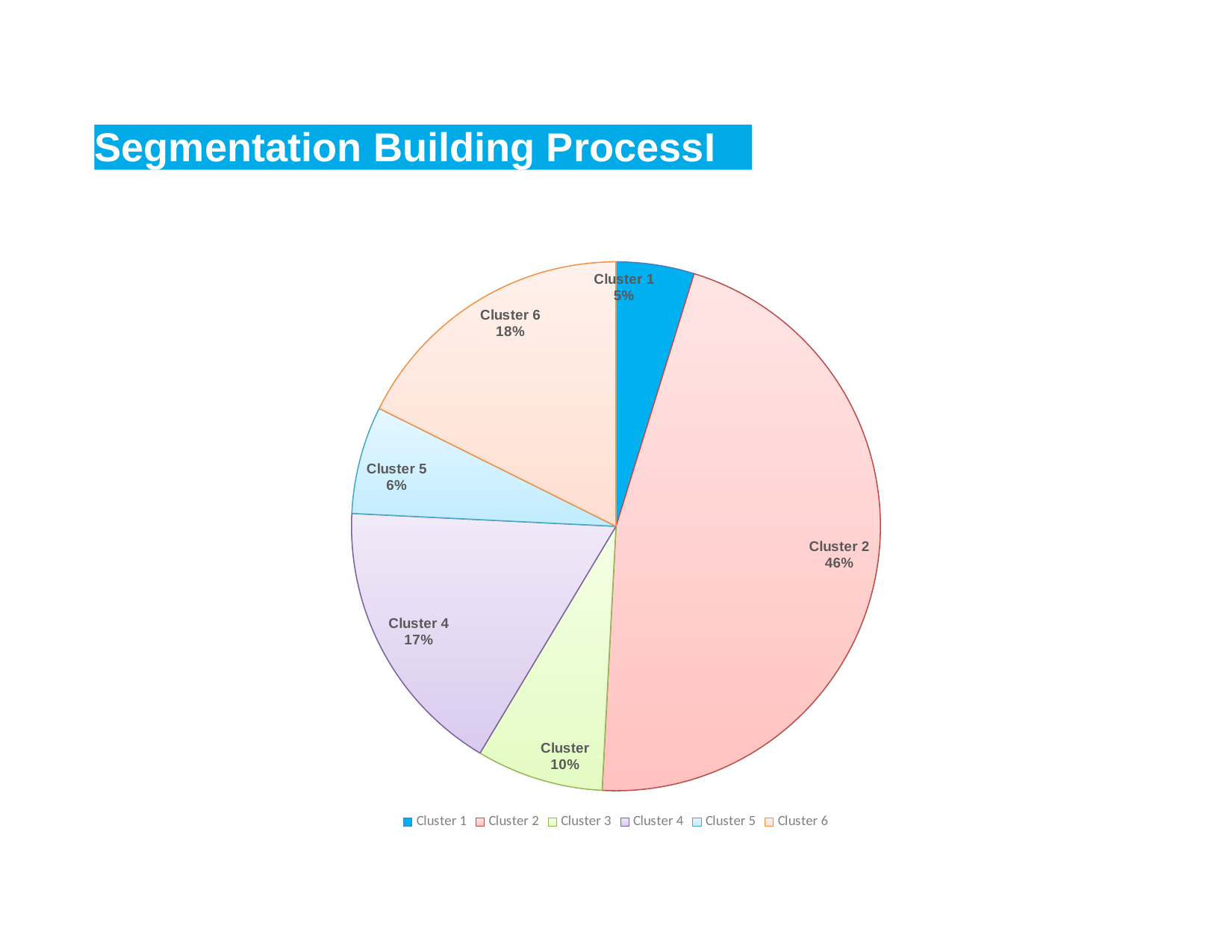
Which cluster has the largest slice of the pie? Cluster 2 Which is larger, the share for Cluster 4 or the share for Cluster 5? Cluster 4 What share of the pie does Cluster 6 represent? 18% What share of the pie does Cluster 5 represent? 6% How many clusters does the legend list? 6 What is the title shown at the top of the slide? Segmentation Building ProcessI What is the difference in percentage points between Cluster 2 and Cluster 6? 28 What share of the pie does Cluster 4 represent? 17% Which cluster has the smallest slice of the pie? Cluster 1 What kind of chart is shown on the slide? pie chart